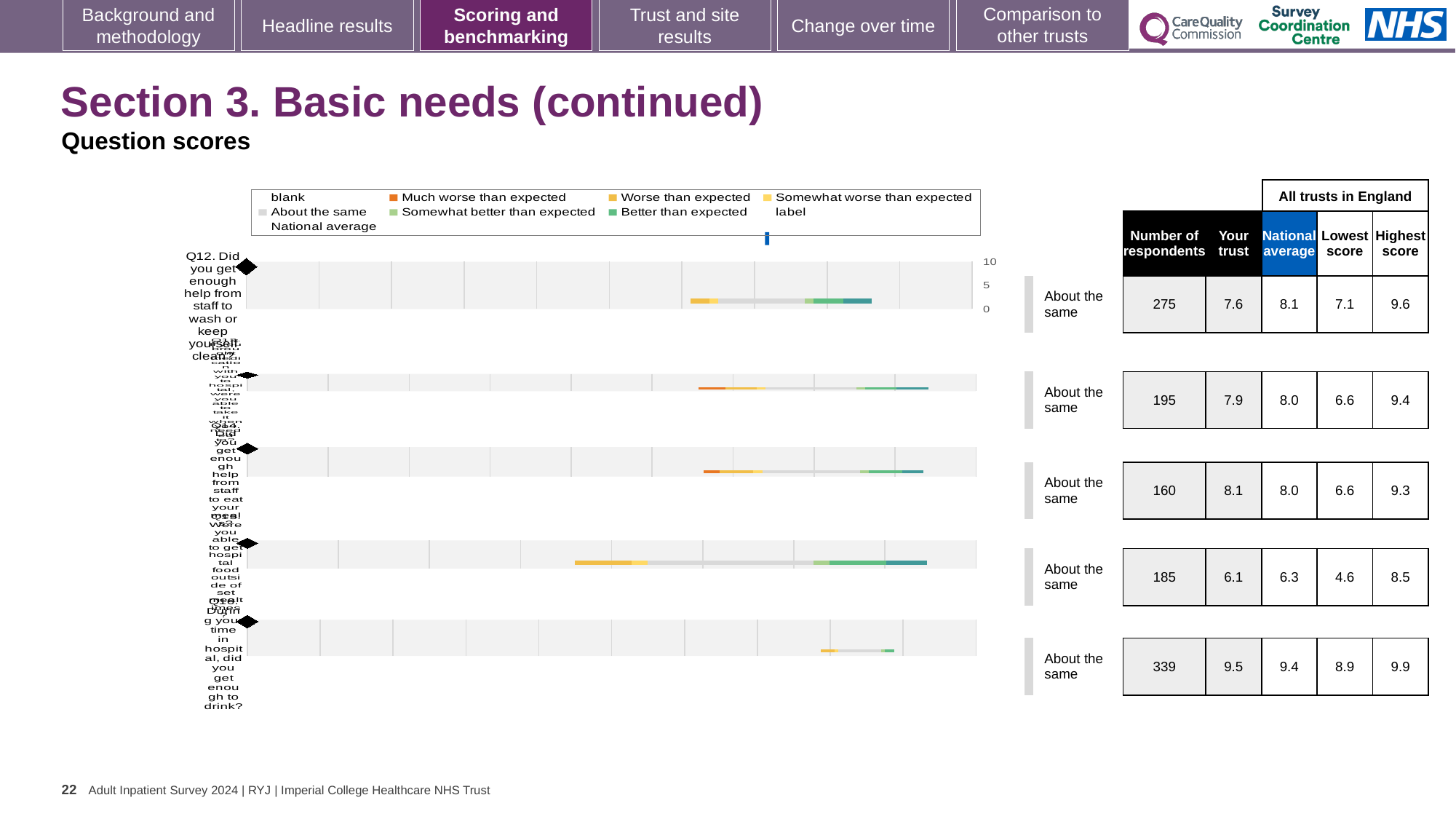
What benchmark category is shown for the first chart (Q12)? About the same In the chart legend, what colour represents 'Much worse than expected'? orange In the chart legend, what does the blue vertical marker represent? National average For the first chart (Q12, help from staff to wash or keep yourself clean), what is the 'Your trust' score shown alongside it? 7.6 How many respondents are shown for the first chart (Q12)? 275 For the first chart (Q12), what is the national average score shown alongside it? 8.1 What kind of chart is used to show the question scores on this slide? bar chart Which of the five charts has the lowest 'Your trust' score, and what is it? the fourth chart, 6.1 For the first chart (Q12), what is the difference between the highest score (9.6) and the lowest score (7.1) across all trusts in England? 2.5 Which of the five charts has the highest 'Your trust' score, and what is it? the fifth (bottom) chart, 9.5 For the first chart (Q12), which is larger: the trust's score or the national average? national average How many separate question charts are stacked on the slide? 5